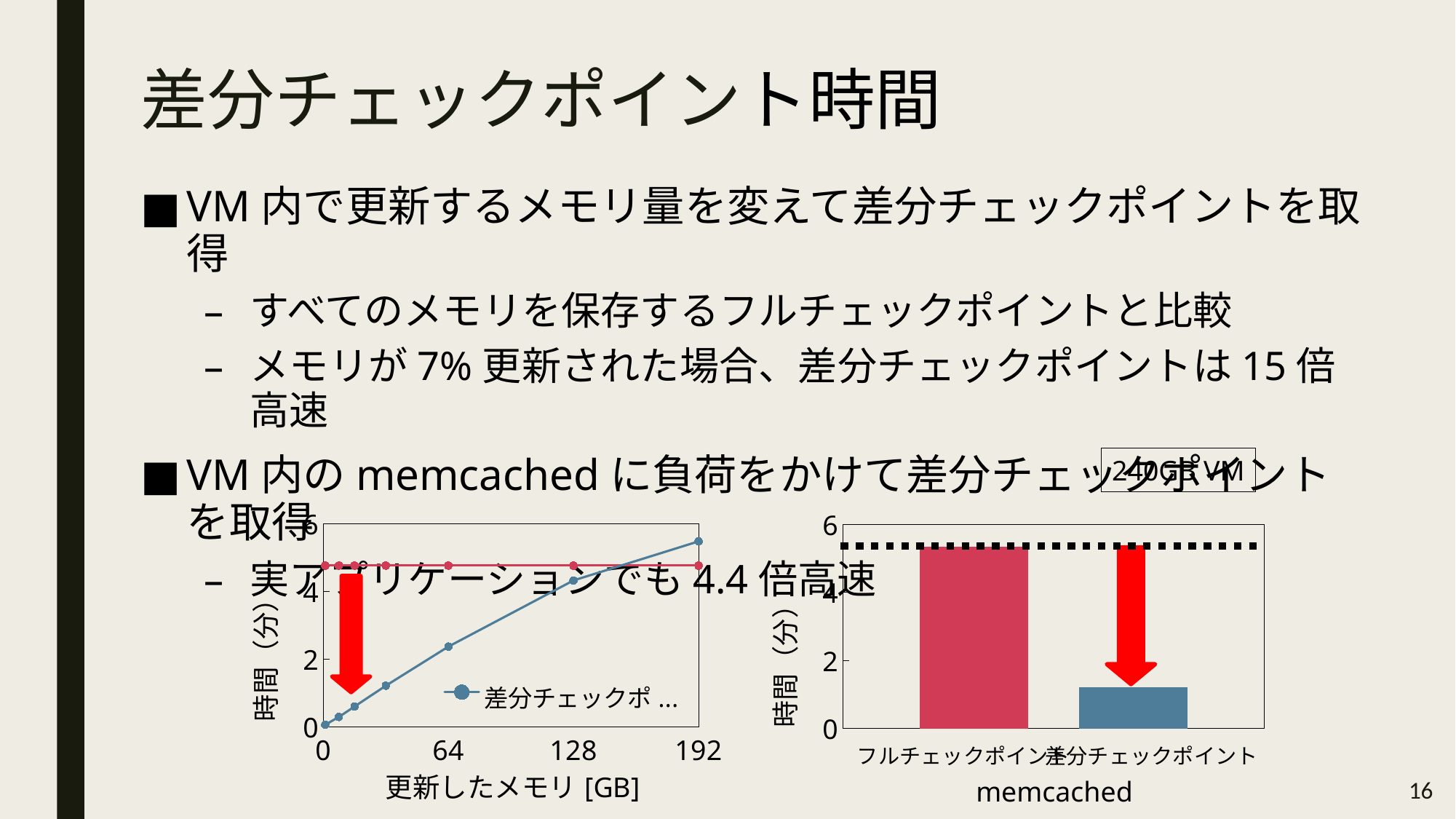
In the left chart, is the value of the blue 差分チェックポイント line at 64 GB greater or less than 4? less In the left chart, what is the x-axis label? 更新したメモリ [GB] In the right chart (memcached), is the value for 差分チェックポイント greater or less than 2? less In the right chart (memcached), is the value for フルチェックポイント greater or less than 4? greater In the right chart (memcached), how many bars are plotted? 2 In the right chart (memcached), which category has the higher value, フルチェックポイント or 差分チェックポイント? フルチェックポイント What kind of chart is the left chart (時間 vs 更新したメモリ [GB])? line chart What kind of chart is the right chart (memcached)? bar chart In the left chart, does the blue 差分チェックポイント line rise or fall as 更新したメモリ increases? rises In the right chart, what is the y-axis label? 時間（分） In the right chart (memcached), which category has the lowest value? 差分チェックポイント